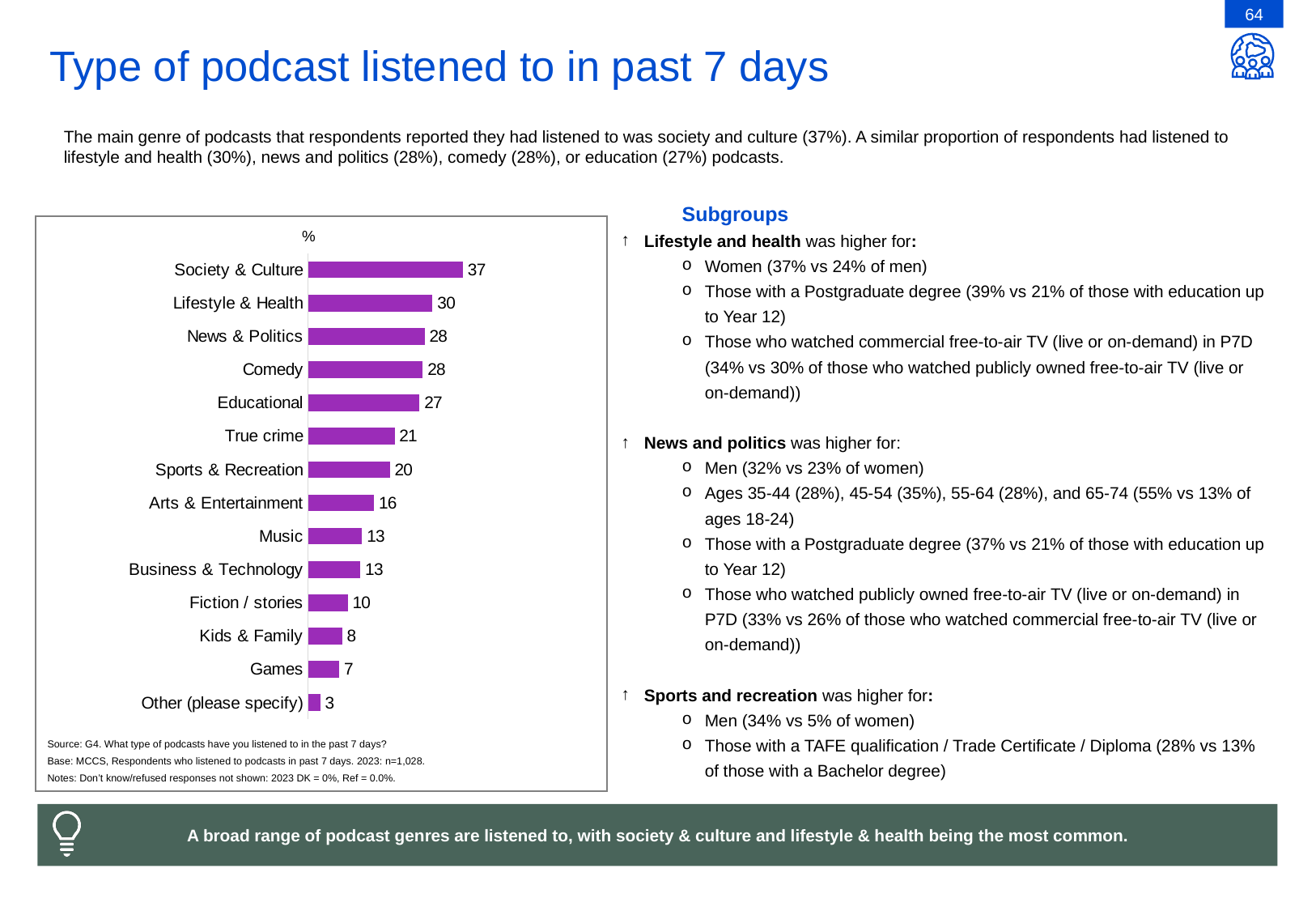
What kind of chart is shown on the slide? Bar chart Which is larger, the value for Arts & Entertainment or the value for Fiction / stories? Arts & Entertainment What is the value for Society & Culture? 37 What is the difference between the values for Sports & Recreation and Games? 13 How many categories are shown in the chart? 14 What is the difference between the values for Society & Culture and Lifestyle & Health? 7 What colour are the bars in the chart? Purple Which category has the highest value? Society & Culture What is the value for Kids & Family? 8 What is the value for True crime? 21 Do the values rise or fall going from the top category to the bottom category? Fall Which category has the lowest value? Other (please specify)